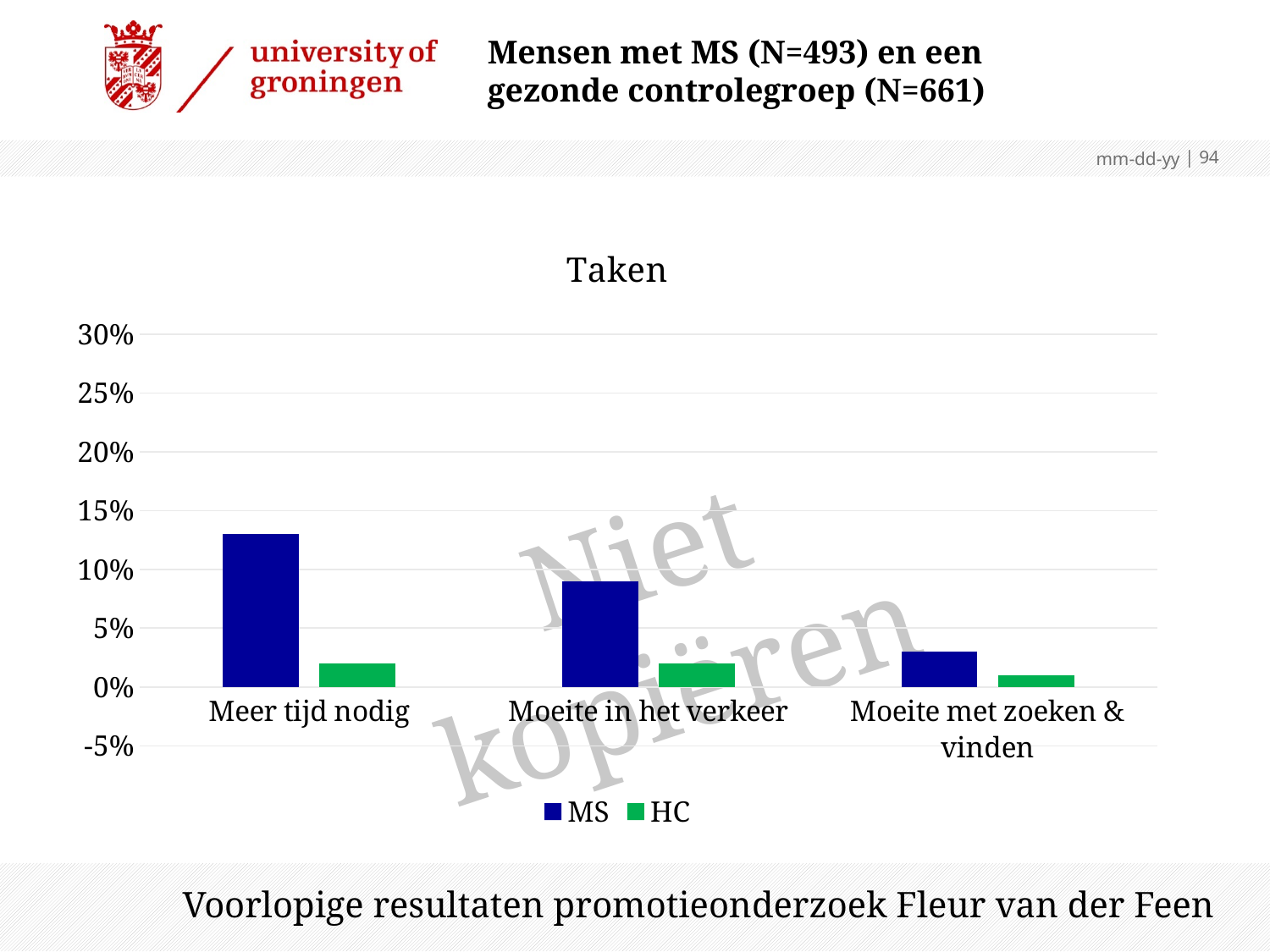
Is the HC value for Meer tijd nodig greater or less than 5%? less Is the MS value for Moeite in het verkeer greater or less than 10%? less Is the MS value for Meer tijd nodig greater or less than 10%? greater What kind of chart is shown on the slide? bar chart Do the MS values rise or fall from left to right across the categories? fall Which is larger for Moeite in het verkeer, the MS value or the HC value? MS How many series does the legend list? 2 Which category has the lowest MS value? Moeite met zoeken & vinden How many categories are shown on the x axis? 3 Which category has the highest MS value? Meer tijd nodig What is the title of the chart? Taken